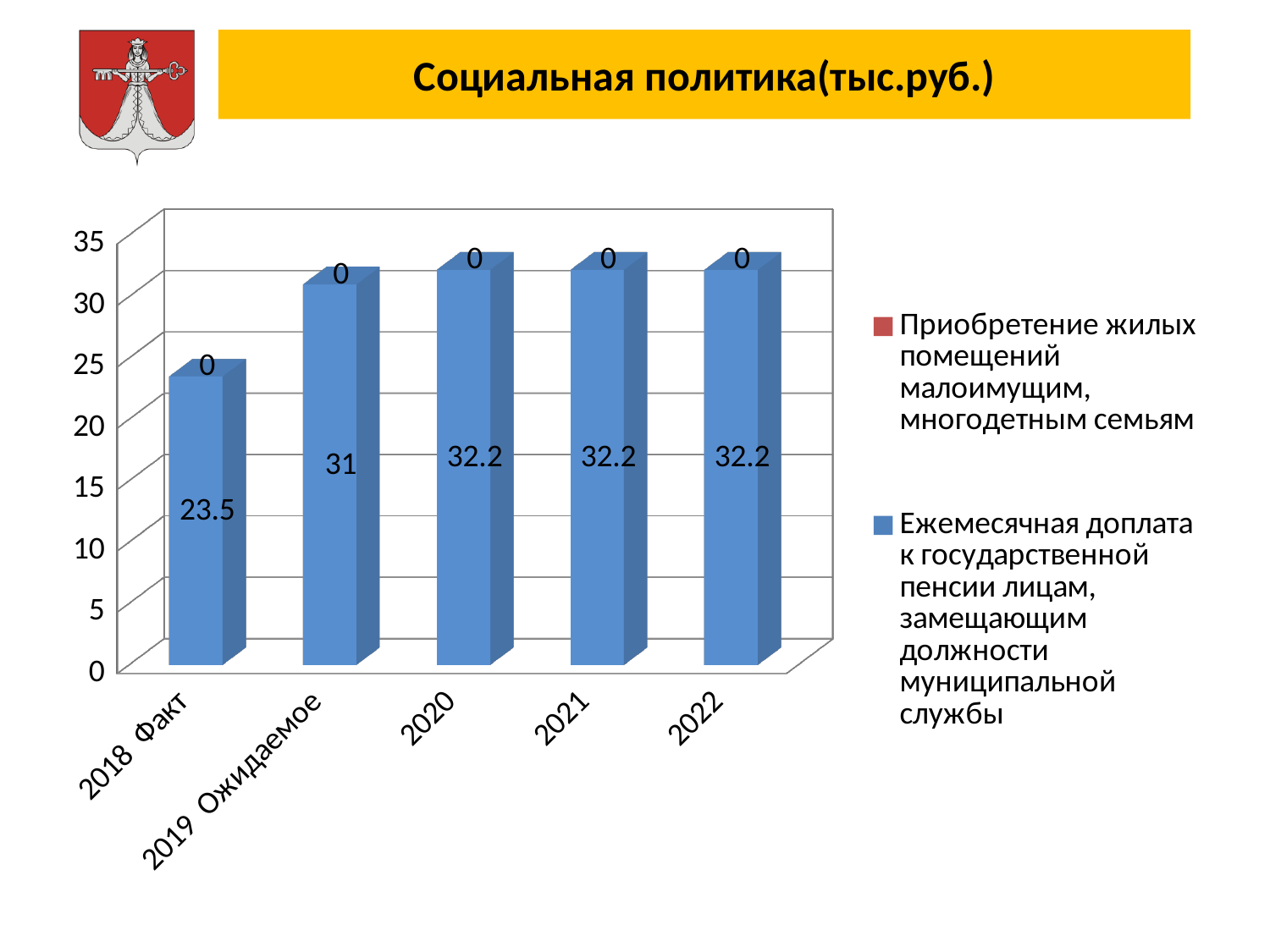
Which is larger: the monthly pension supplement value for 2020 or for 2019 Ожидаемое? 2020 What is the difference between the monthly pension supplement values for 2019 Ожидаемое and 2018 Факт? 7.5 Do the monthly pension supplement values rise or fall from 2018 Факт to 2020? Rise What is the value of the monthly pension supplement (Ежемесячная доплата к государственной пенсии) for 2020? 32.2 What is the value of the housing acquisition series (Приобретение жилых помещений малоимущим, многодетным семьям) for 2021? 0 How many series does the legend list? 2 What is the value of the monthly pension supplement (Ежемесячная доплата к государственной пенсии) for 2019 Ожидаемое? 31 What is the value of the monthly pension supplement (Ежемесячная доплата к государственной пенсии) for 2018 Факт? 23.5 What kind of chart is shown on the slide? Bar chart How many categories are shown on the x axis? 5 Which category has the lowest value for the monthly pension supplement series? 2018 Факт What is the title of the chart on the slide? Социальная политика(тыс.руб.)